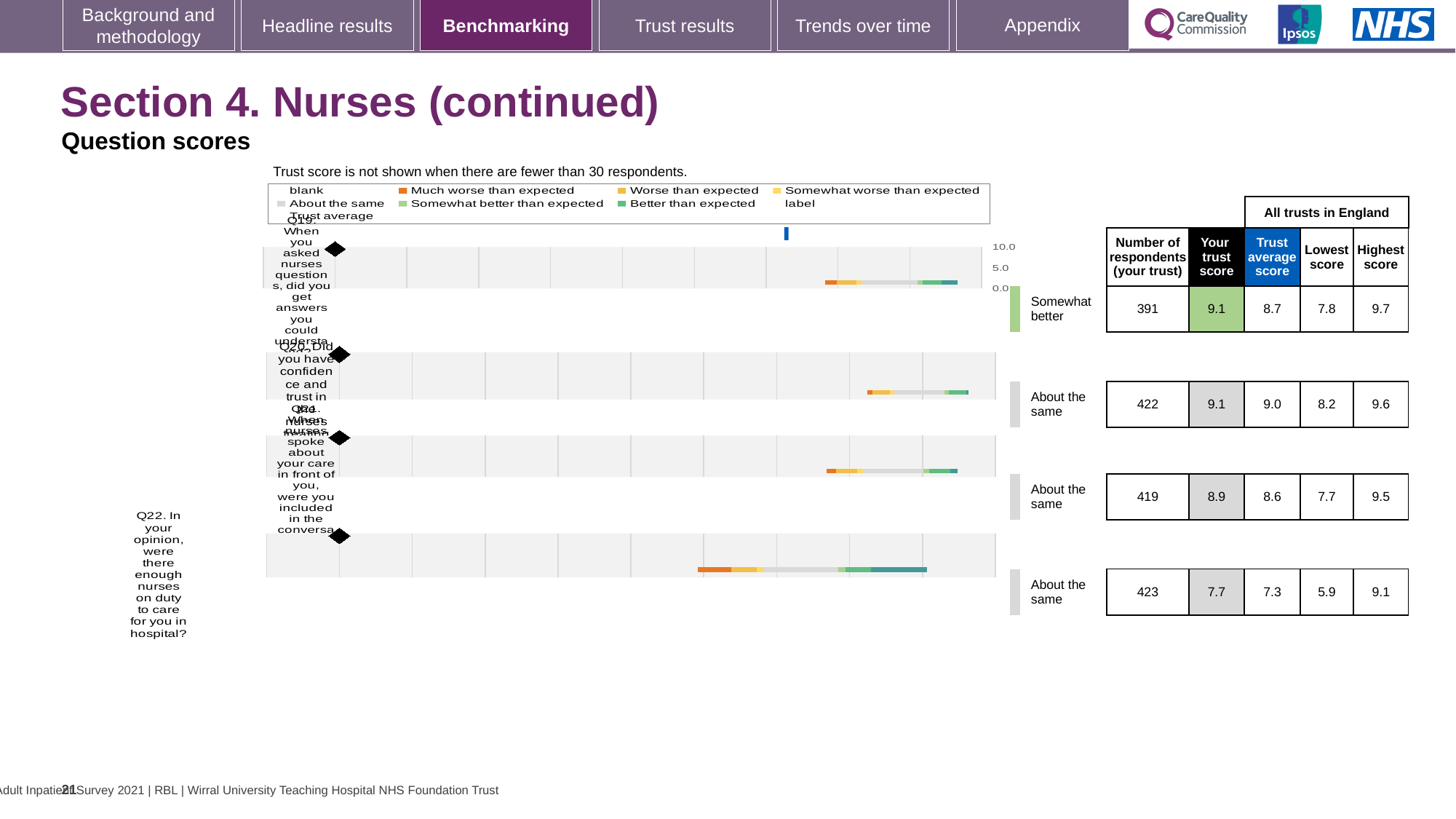
Which question has the lowest 'Your trust score' in the table? Q22 What kind of chart is shown on the slide? Bar chart In the table, what is the trust average score for Q20? 9.0 For Q19, what is the difference between 'Your trust score' and the trust average score? 0.4 In the table, what is the highest score for Q21? 9.5 In the table, what is the 'Your trust score' for Q22? 7.7 In the table, what is the lowest score for Q22? 5.9 For Q22, what is the difference between the highest score and the lowest score? 3.2 How many questions are plotted in the chart? 4 For Q20, which is larger: 'Your trust score' or the trust average score? Your trust score In the table, how many respondents (your trust) are shown for Q19? 391 Which question has the highest number of respondents (your trust) in the table? Q22